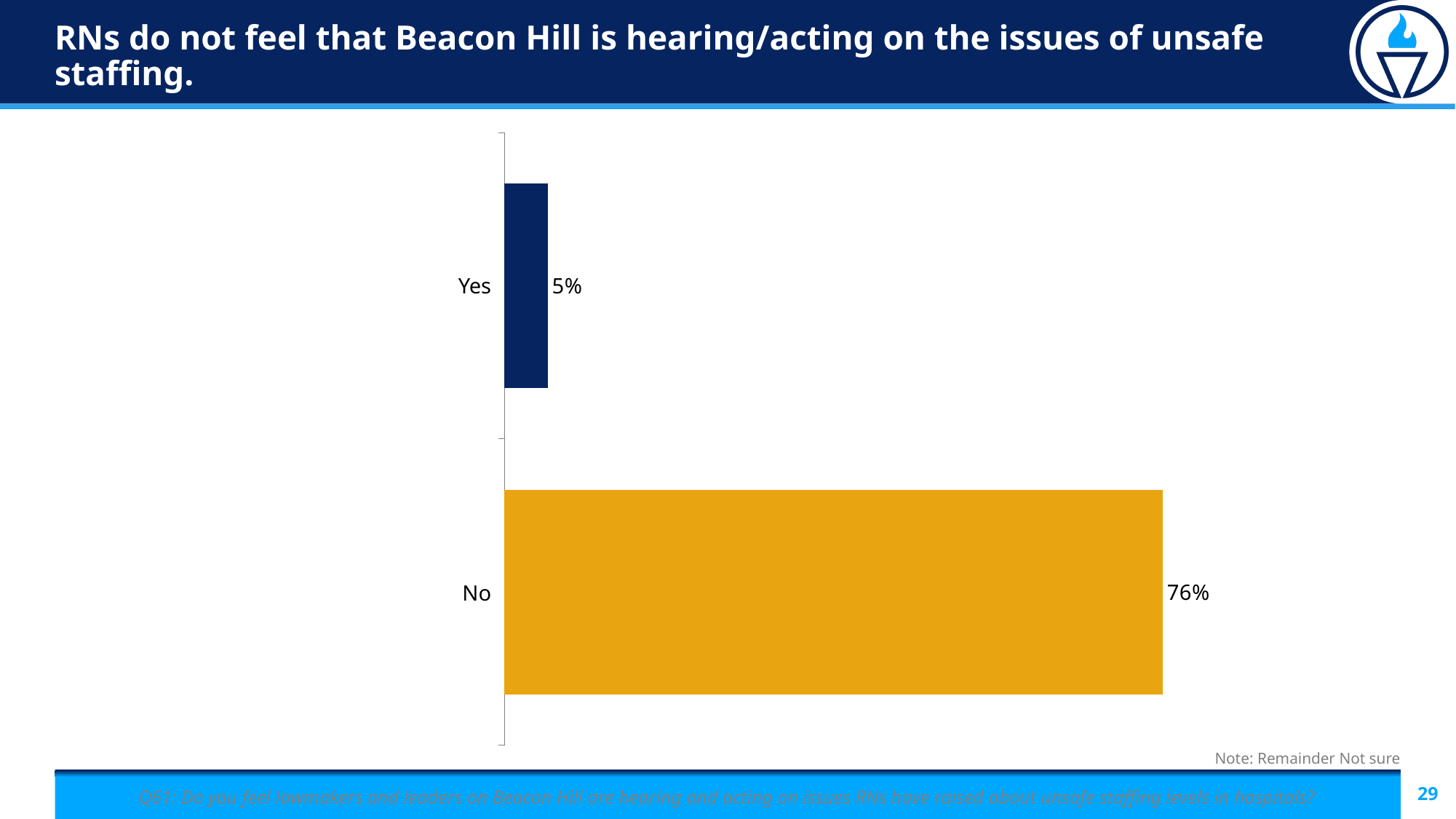
Which category has the lowest value? Yes According to the note on the slide, what does the remainder of responses represent? Not sure Which category has the highest value? No What is the difference in percentage points between the No and Yes responses? 71 What percentage of RNs answered No? 76% How many categories are shown in the chart? 2 What colour is the bar for No? Orange/gold What kind of chart is shown on the slide? Bar chart What percentage of RNs answered Yes? 5% Which is larger, the value for Yes or the value for No? No